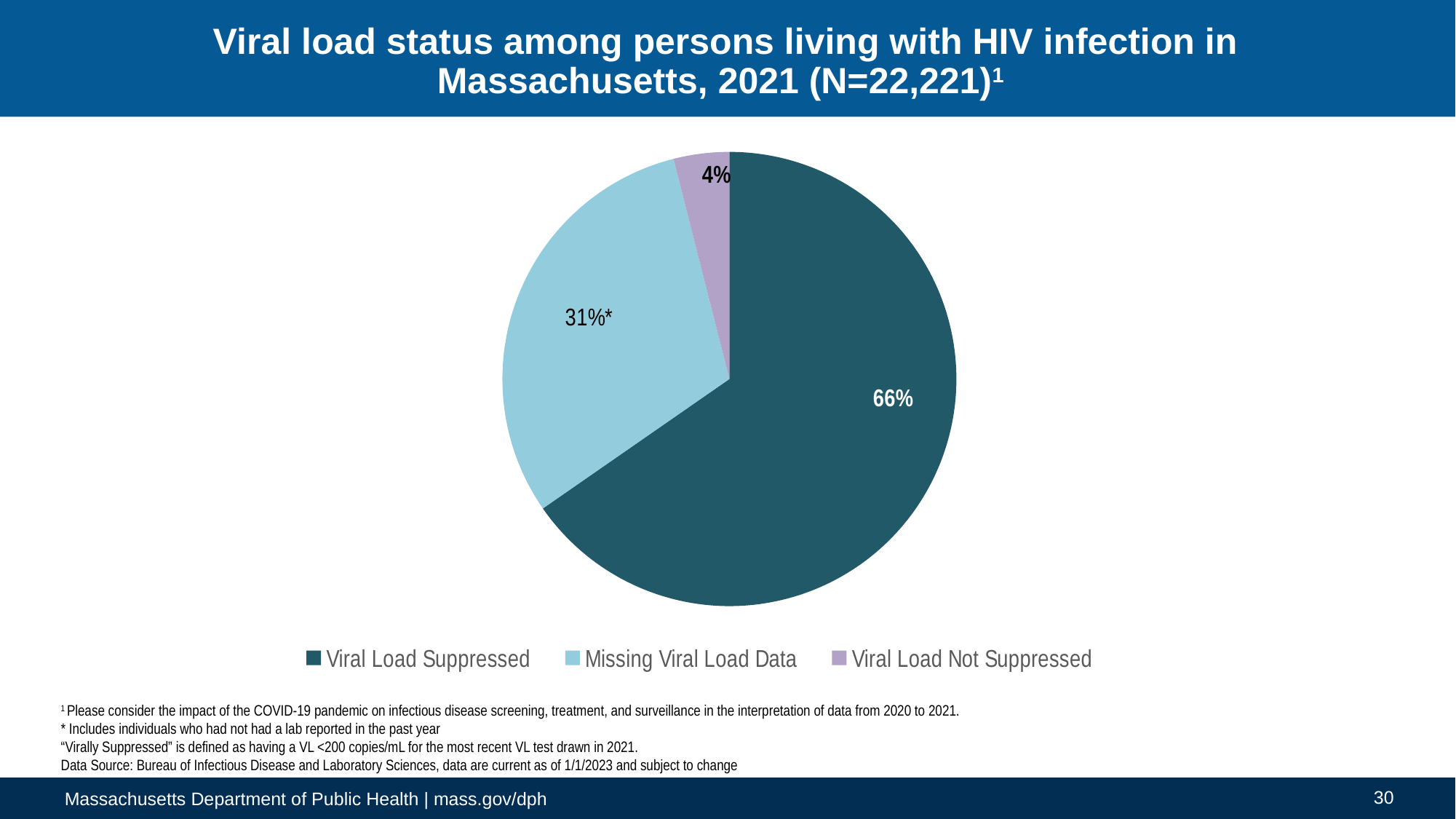
What percentage is shown for Viral Load Not Suppressed? 4% Which legend entry is shown in the light purple colour? Viral Load Not Suppressed Which category has the smallest share of the pie? Viral Load Not Suppressed Which is larger, the share for Missing Viral Load Data or the share for Viral Load Not Suppressed? Missing Viral Load Data What is the total N given in the chart title? 22,221 How many categories does the pie chart show? 3 What is the difference in percentage points between Viral Load Suppressed and Missing Viral Load Data? 35 What kind of chart is shown on the slide? pie chart Which category has the largest share of the pie? Viral Load Suppressed How many entries does the legend list? 3 What percentage is shown for Missing Viral Load Data? 31%* What percentage of persons living with HIV infection in Massachusetts in 2021 had Viral Load Suppressed? 66%